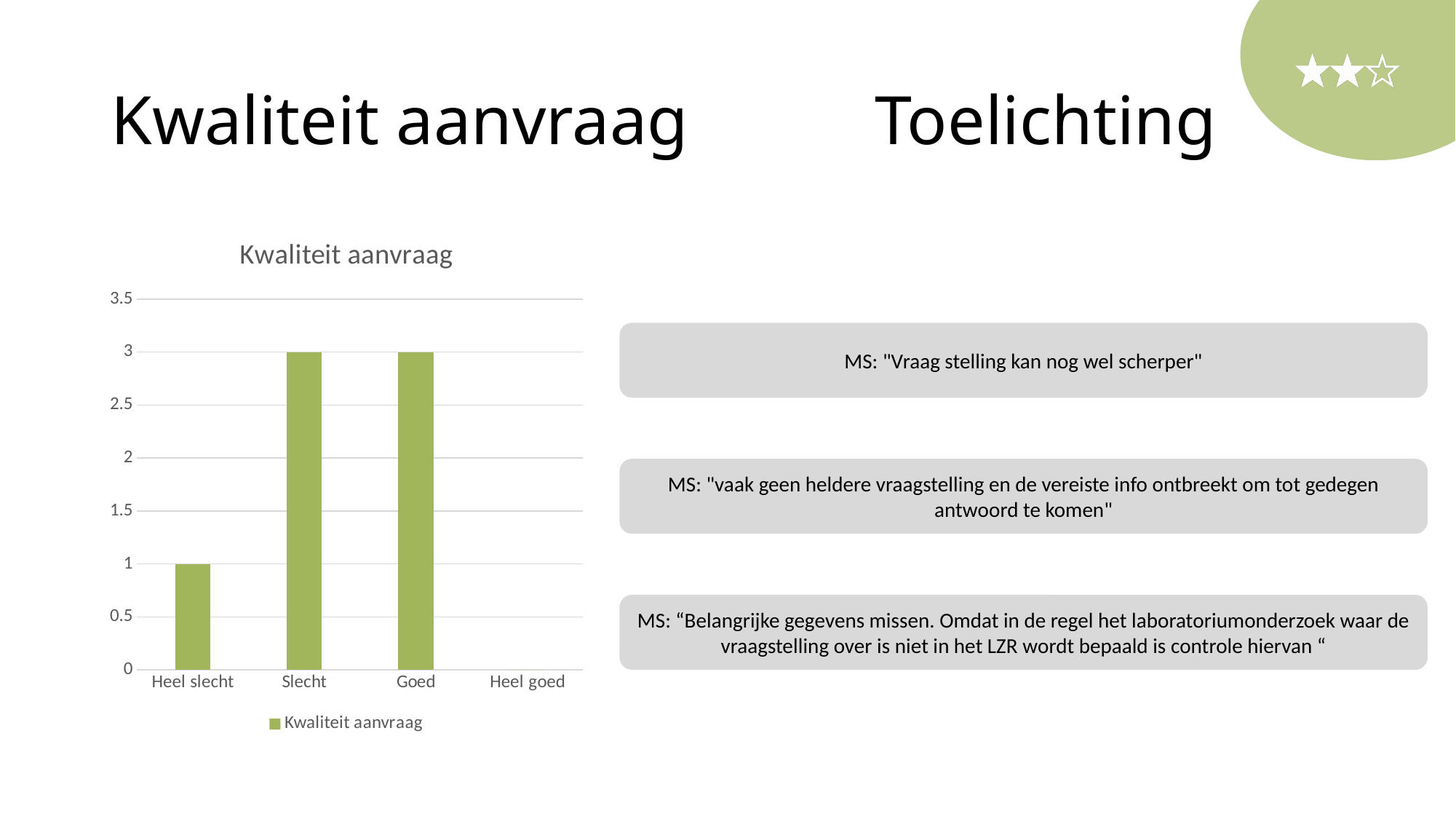
Which is larger in the Kwaliteit aanvraag chart, Heel slecht or Slecht? Slecht What kind of chart is shown on the slide? Bar chart What is the value for Slecht in the Kwaliteit aanvraag chart? 3 What is the value for Heel slecht in the Kwaliteit aanvraag chart? 1 Is the value for Goed greater or less than 2 in the Kwaliteit aanvraag chart? greater What is the value for Goed in the Kwaliteit aanvraag chart? 3 How many series does the legend of the Kwaliteit aanvraag chart list? 1 How many categories are shown on the x axis of the Kwaliteit aanvraag chart? 4 What is the value for Heel goed in the Kwaliteit aanvraag chart? 0 What is the title of the chart on the slide? Kwaliteit aanvraag What is the difference between the values for Slecht and Heel slecht in the Kwaliteit aanvraag chart? 2 Which category has the lowest value in the Kwaliteit aanvraag chart? Heel goed